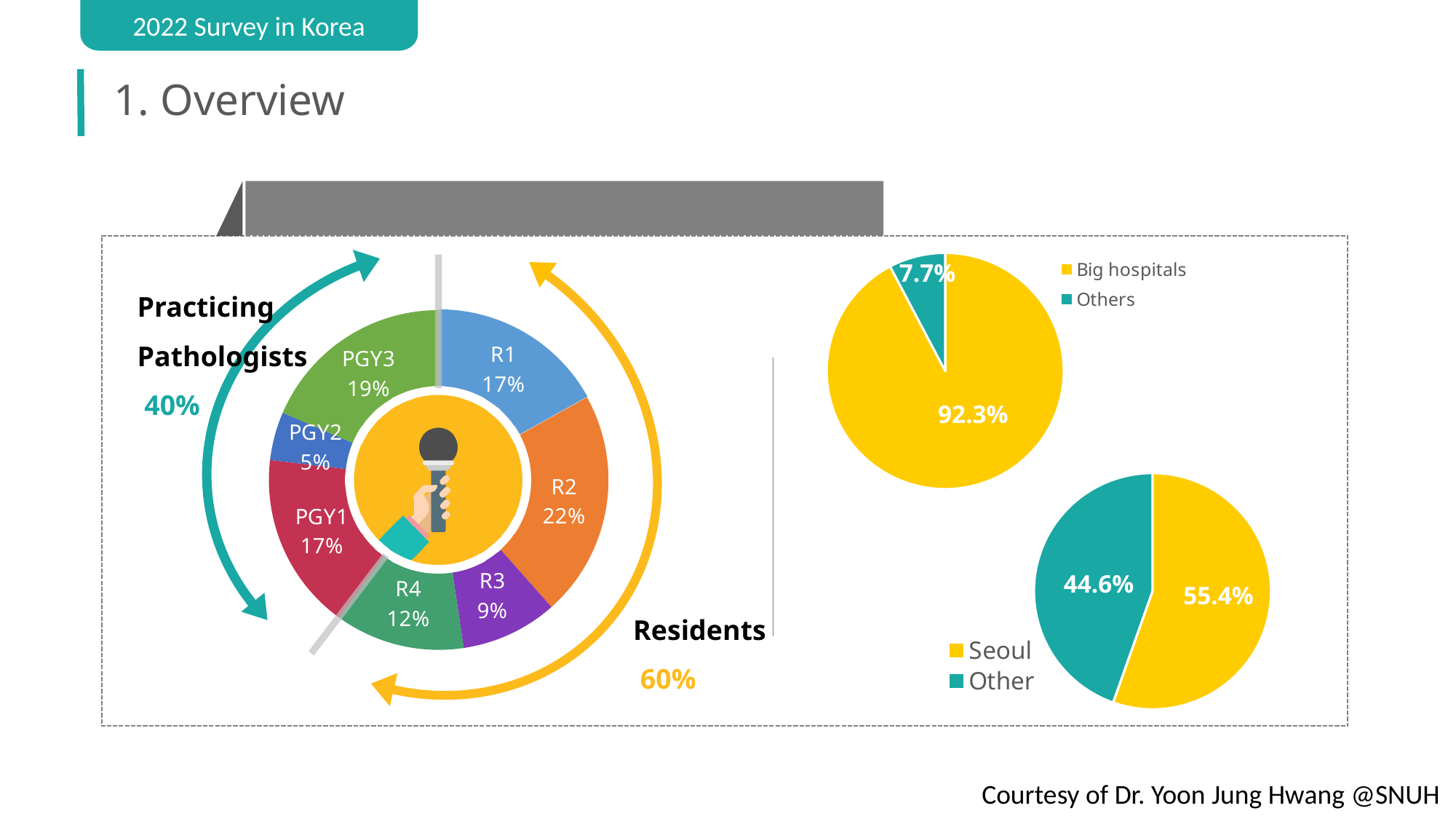
In the donut chart on the left, what is the value for PGY3? 19% In the donut chart on the left, which segment has the largest value? R2 In the donut chart on the left, what is the value for R2? 22% How many segments does the donut chart on the left have? 7 In the donut chart on the left, which is larger, the value for R4 or the value for PGY1? PGY1 In the donut chart on the left, what is the difference between the values for R2 and R3? 13% In the pie chart at the top right, what is the share for Big hospitals? 92.3% In the pie chart at the bottom right, what is the difference between the Seoul and Other shares? 10.8% What type of chart is shown at the bottom right of the slide? Pie chart In the pie chart at the top right, what is the share for Others? 7.7% In the pie chart at the bottom right, what is the share for Seoul? 55.4% In the donut chart on the left, which segment has the smallest value? PGY2